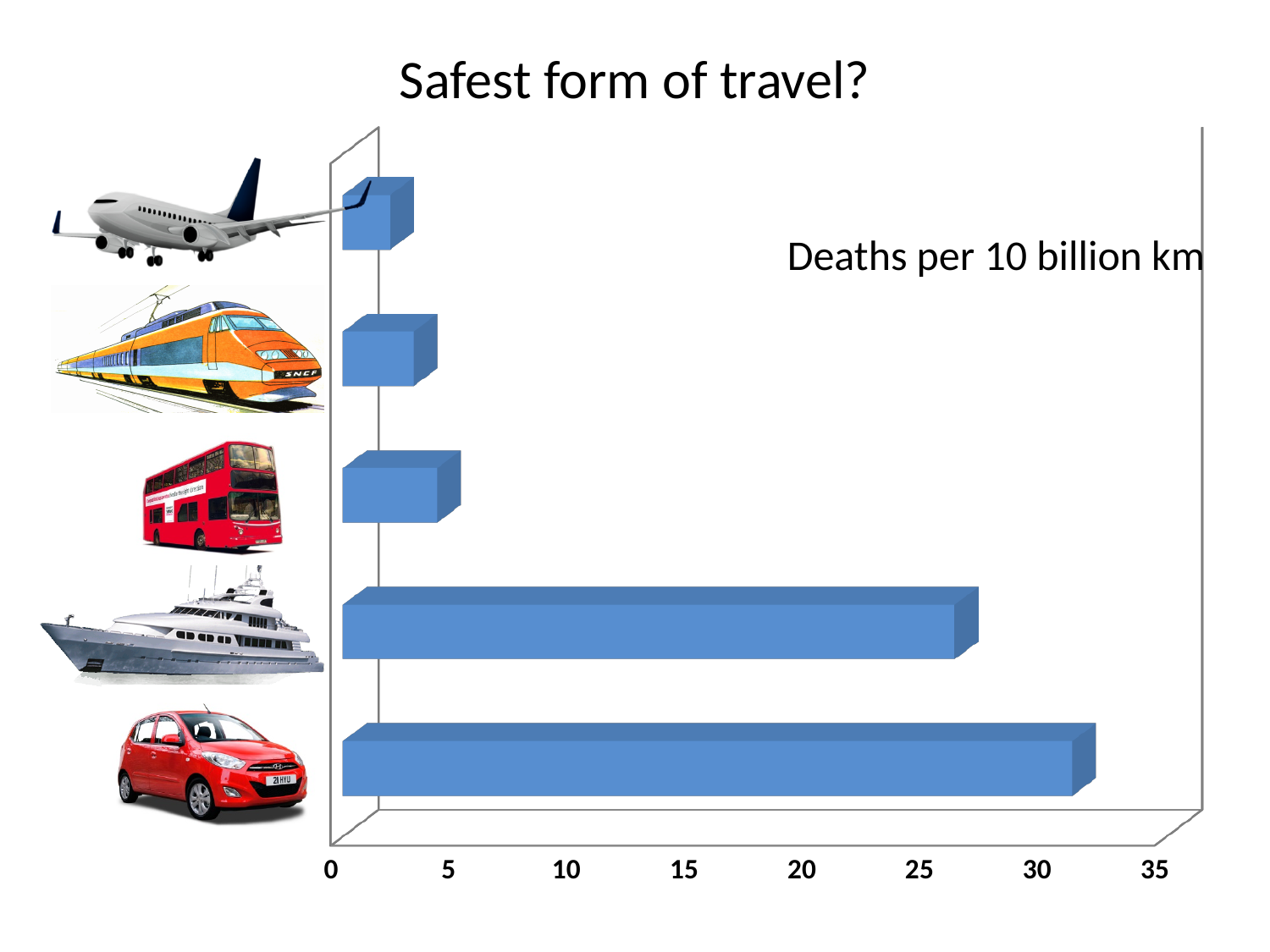
Is the value of the fourth bar from the top (next to the boat) greater or less than 20? greater Is the value of the top bar (next to the aeroplane) greater or less than 5? less What quantity does the chart say it measures, according to the text inside the plot area? Deaths per 10 billion km What is the title of the slide above the chart? Safest form of travel? Is the value of the third bar from the top (next to the bus) greater or less than 10? less Which is larger: the value of the bottom bar (car) or the fourth bar from the top (boat)? the bottom bar (car) Which bar is the longest: the top bar (next to the aeroplane) or the bottom bar (next to the car)? the bottom bar (car) What is the highest value shown on the horizontal axis? 35 What kind of chart is shown on the slide? bar chart How many bars does the chart show? 5